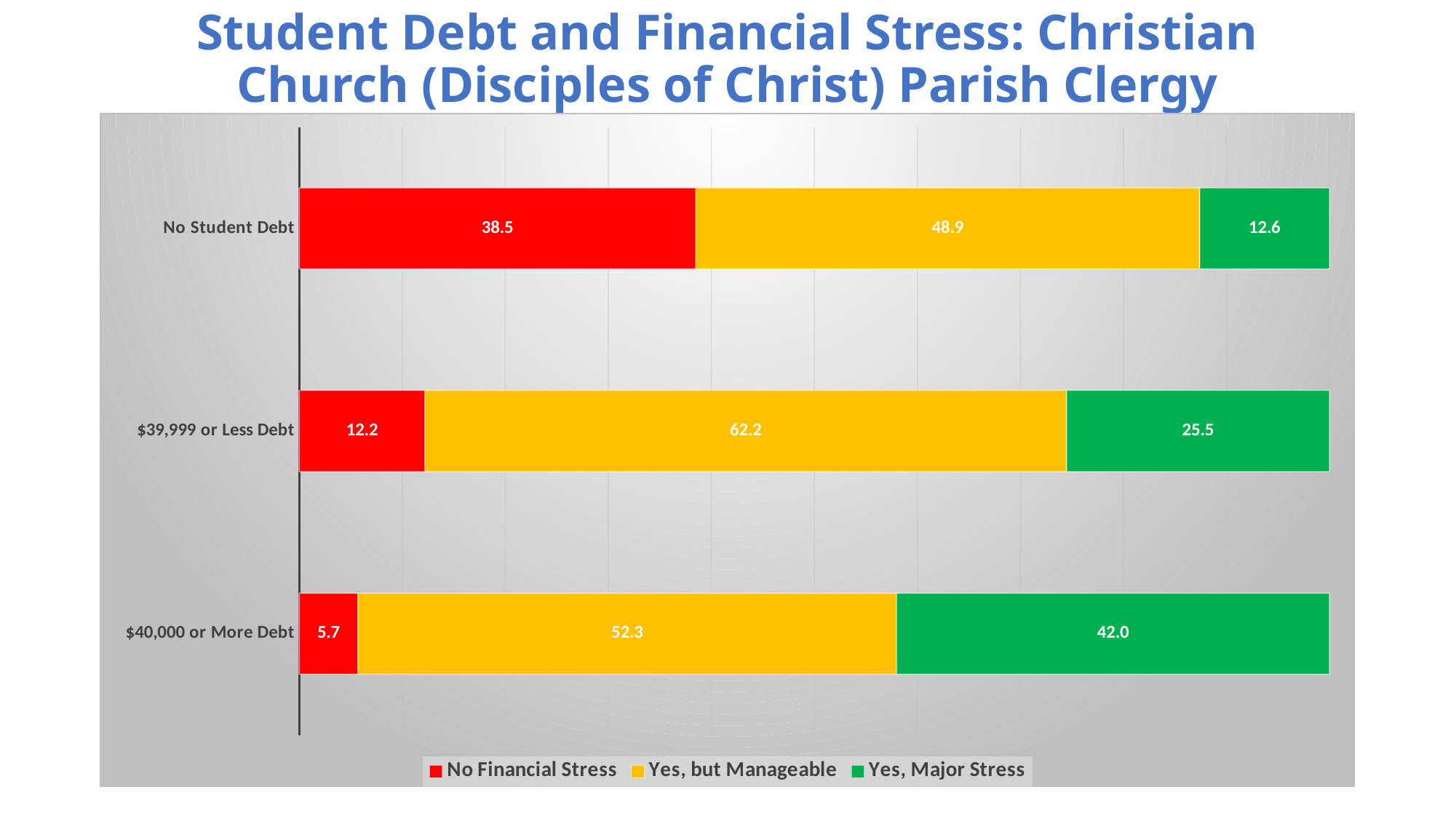
How many series does the legend list? 3 What is the value for "Yes, but Manageable" in the "$39,999 or Less Debt" category? 62.2 What is the difference between the "Yes, Major Stress" values for "$40,000 or More Debt" and "No Student Debt"? 29.4 What kind of chart is shown on the slide? Stacked bar chart Which is larger: the "No Financial Stress" value for "No Student Debt" or for "$39,999 or Less Debt"? No Student Debt What is the value for "No Financial Stress" in the "No Student Debt" category? 38.5 How many categories are shown on the chart? 3 Which category has the highest value for "Yes, Major Stress"? $40,000 or More Debt Which category has the lowest value for "No Financial Stress"? $40,000 or More Debt Which colour represents "Yes, but Manageable" in the legend? Yellow What is the total of the stacked bar for "$39,999 or Less Debt"? 99.9 What is the value for "Yes, Major Stress" in the "$40,000 or More Debt" category? 42.0